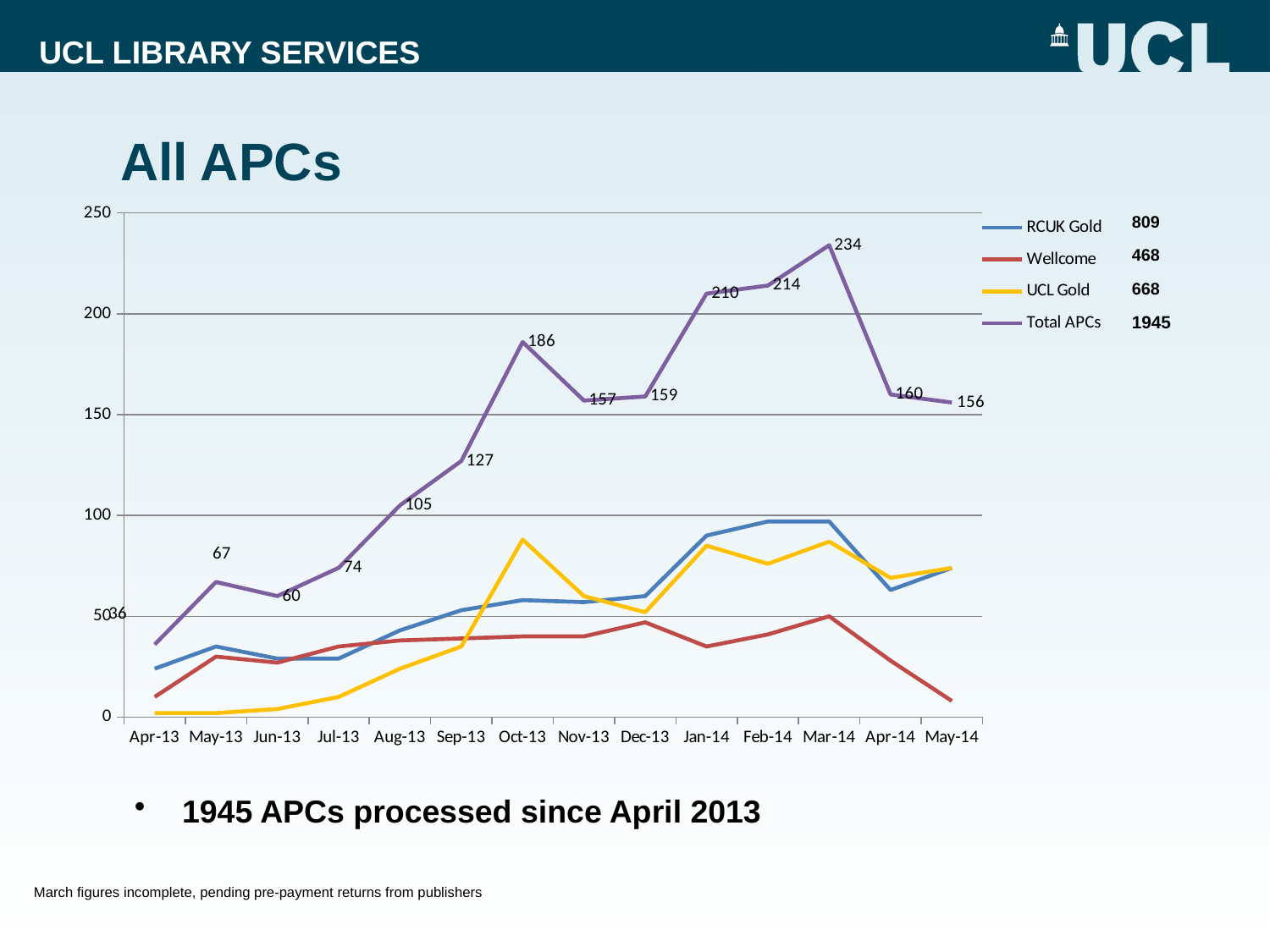
Is the UCL Gold value for Oct-13 greater or less than 50? greater What is the Total APCs value for Mar-14? 234 Which month has the larger Total APCs value, Jan-14 or Feb-14? Feb-14 What is the Total APCs value for Jul-13? 74 What kind of chart is shown on the slide? Line chart How many series does the legend list? 4 In which month is the Total APCs value lowest? Apr-13 Is the Wellcome value for May-14 greater or less than 50? less In which month is the Total APCs value highest? Mar-14 What is the Total APCs value for Oct-13? 186 What is the difference between the Total APCs values for Mar-14 and Apr-14? 74 How many months are shown on the x axis? 14